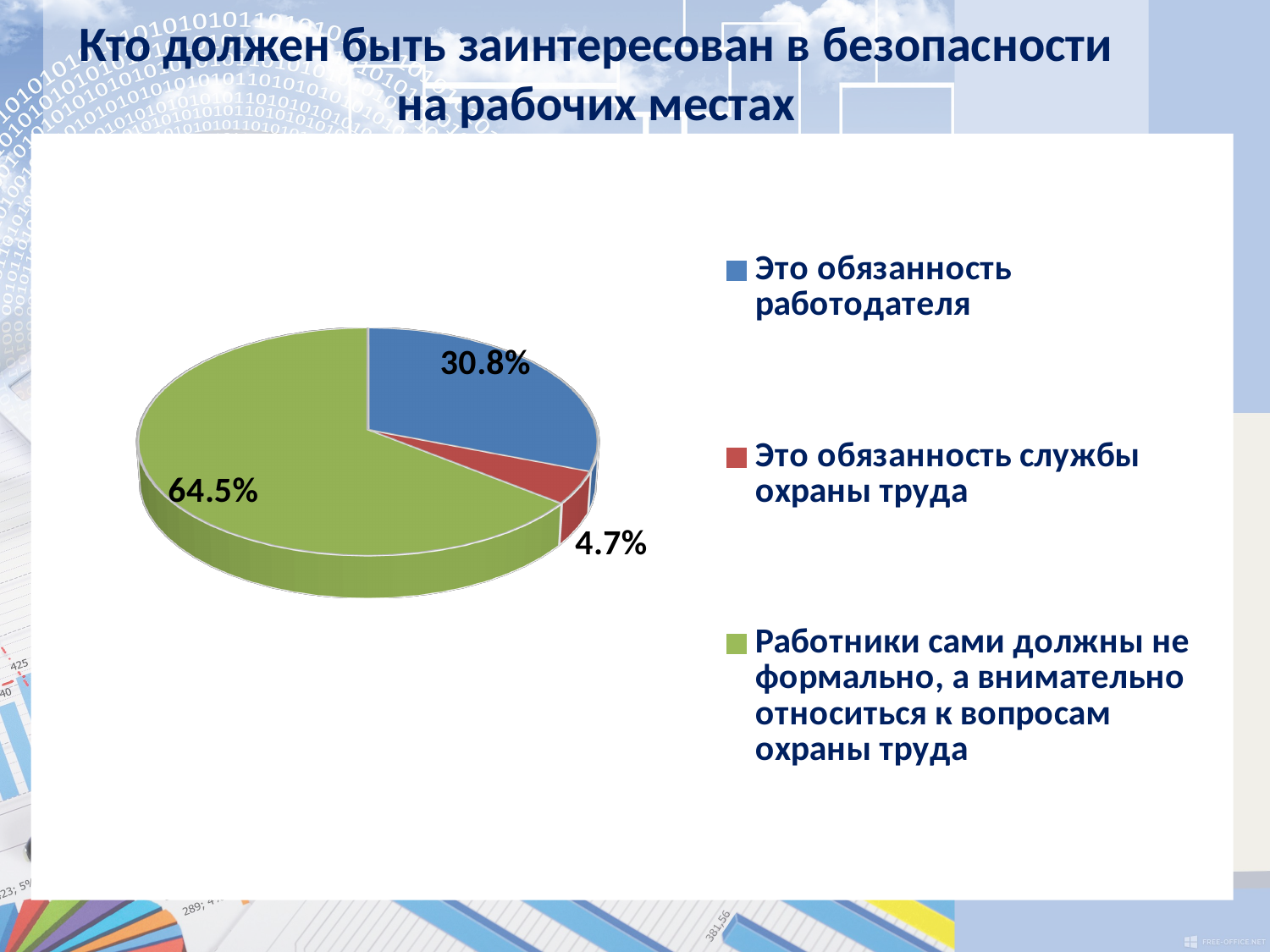
What share of the pie is labelled "Это обязанность работодателя"? 30.8% What share of the pie is labelled "Работники сами должны не формально, а внимательно относиться к вопросам охраны труда"? 64.5% Which is larger: the share for "Это обязанность работодателя" or the share for "Это обязанность службы охраны труда"? Это обязанность работодателя What is the difference between the share for "Это обязанность работодателя" and the share for "Это обязанность службы охраны труда"? 26.1% What colour is the slice for "Это обязанность службы охраны труда"? red What share of the pie is labelled "Это обязанность службы охраны труда"? 4.7% What is the difference between the share for "Работники сами должны не формально, а внимательно относиться к вопросам охраны труда" and the share for "Это обязанность работодателя"? 33.7% What kind of chart is shown on the slide? pie chart Which category has the smallest slice of the pie? Это обязанность службы охраны труда What is the title of the slide containing the pie chart? Кто должен быть заинтересован в безопасности на рабочих местах Which category has the largest slice of the pie? Работники сами должны не формально, а внимательно относиться к вопросам охраны труда How many slices does the pie chart have? 3